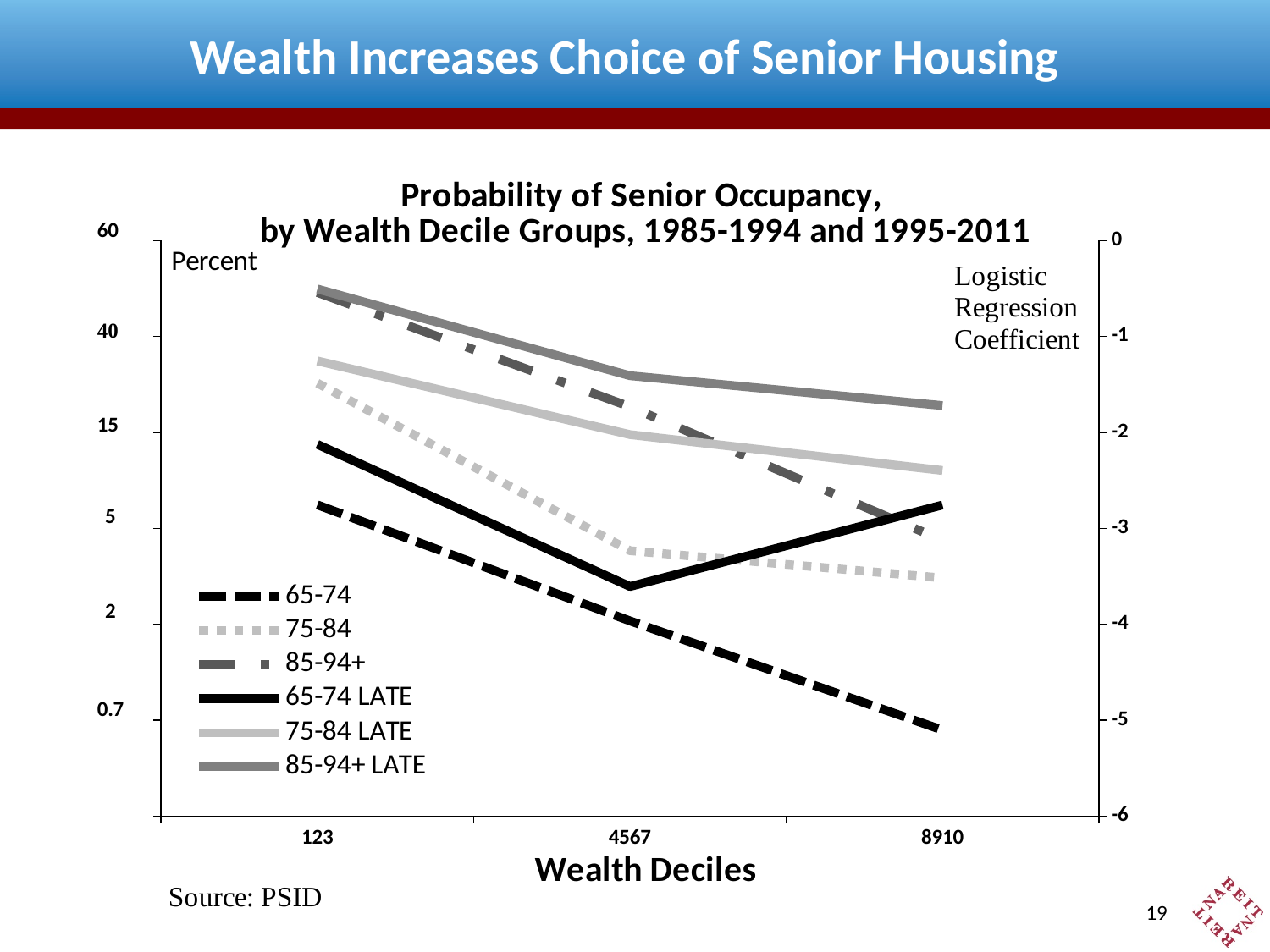
What is the label of the x axis? Wealth Deciles Does the 65-74 line rise or fall from wealth decile 123 to 8910? fall Does the 85-94+ LATE line rise or fall from wealth decile 123 to 8910? fall Is the percent value for 85-94+ LATE at wealth decile 123 greater or less than 40? greater At wealth decile 4567, which is higher: 75-84 or 75-84 LATE? 75-84 LATE Is the percent value for 65-74 at wealth decile 8910 greater or less than 2? less How many wealth decile groups are shown on the x axis? 3 Which series has the lowest value at wealth decile 8910? 65-74 What kind of chart is shown on the slide? line chart How many series does the legend list? 6 Which series has the highest value at wealth decile 8910? 85-94+ LATE At wealth decile 8910, which is higher: 65-74 or 65-74 LATE? 65-74 LATE